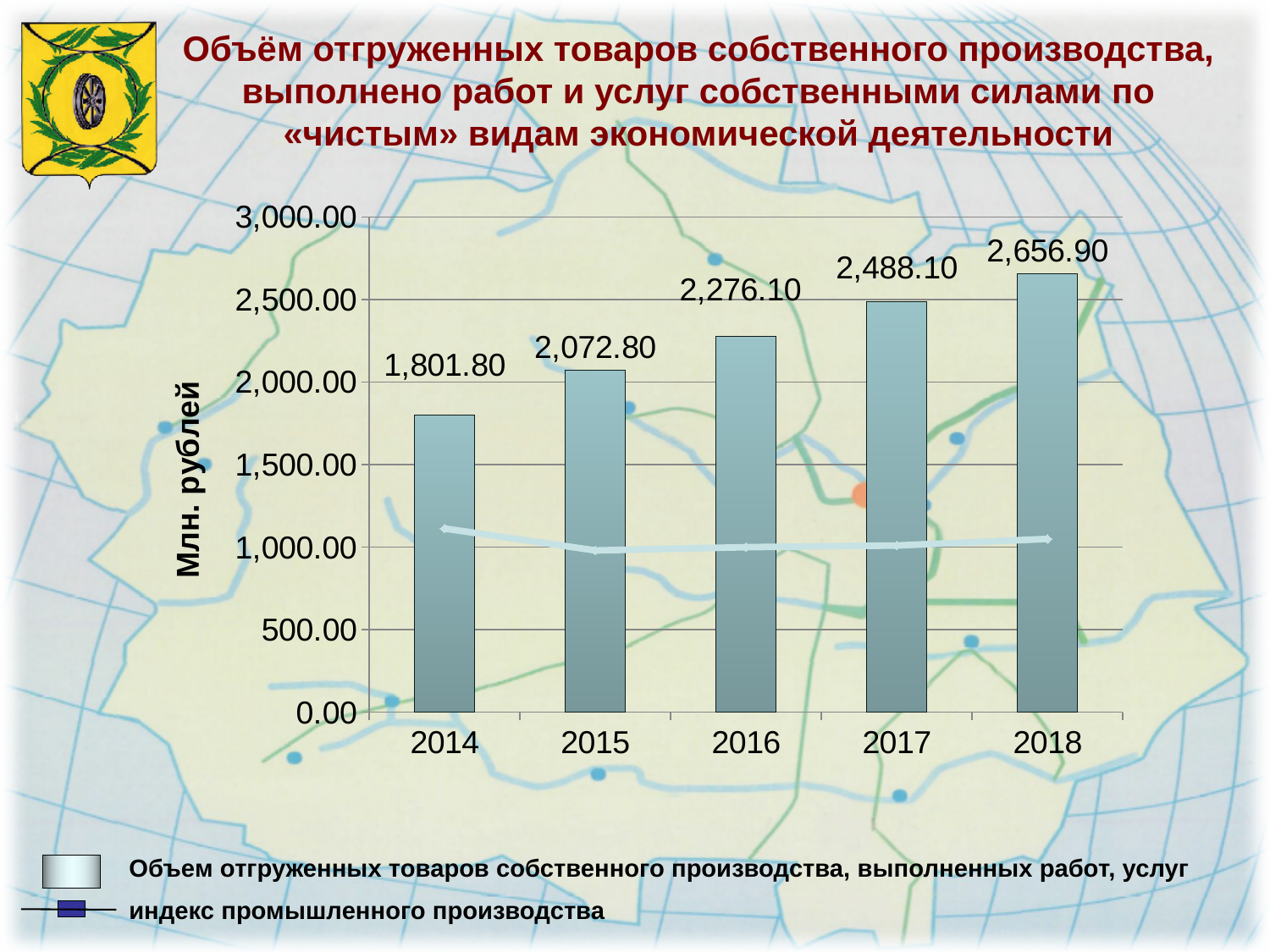
How many years are shown on the x axis? 5 Which year has the highest bar? 2018 Which bar is larger, 2015 or 2017? 2017 What is the value of the bar for 2014? 1,801.80 Do the bar values rise or fall from 2014 to 2018? rise What is the value of the bar for 2018? 2,656.90 What is the difference between the bar values for 2017 and 2016? 212.00 Is the value of the line (индекс промышленного производства) for 2014 greater or less than 1,000.00? greater What is the value of the bar for 2016? 2,276.10 Which year has the lowest bar? 2014 What is the difference between the bar values for 2018 and 2014? 855.10 How many series does the legend list? 2